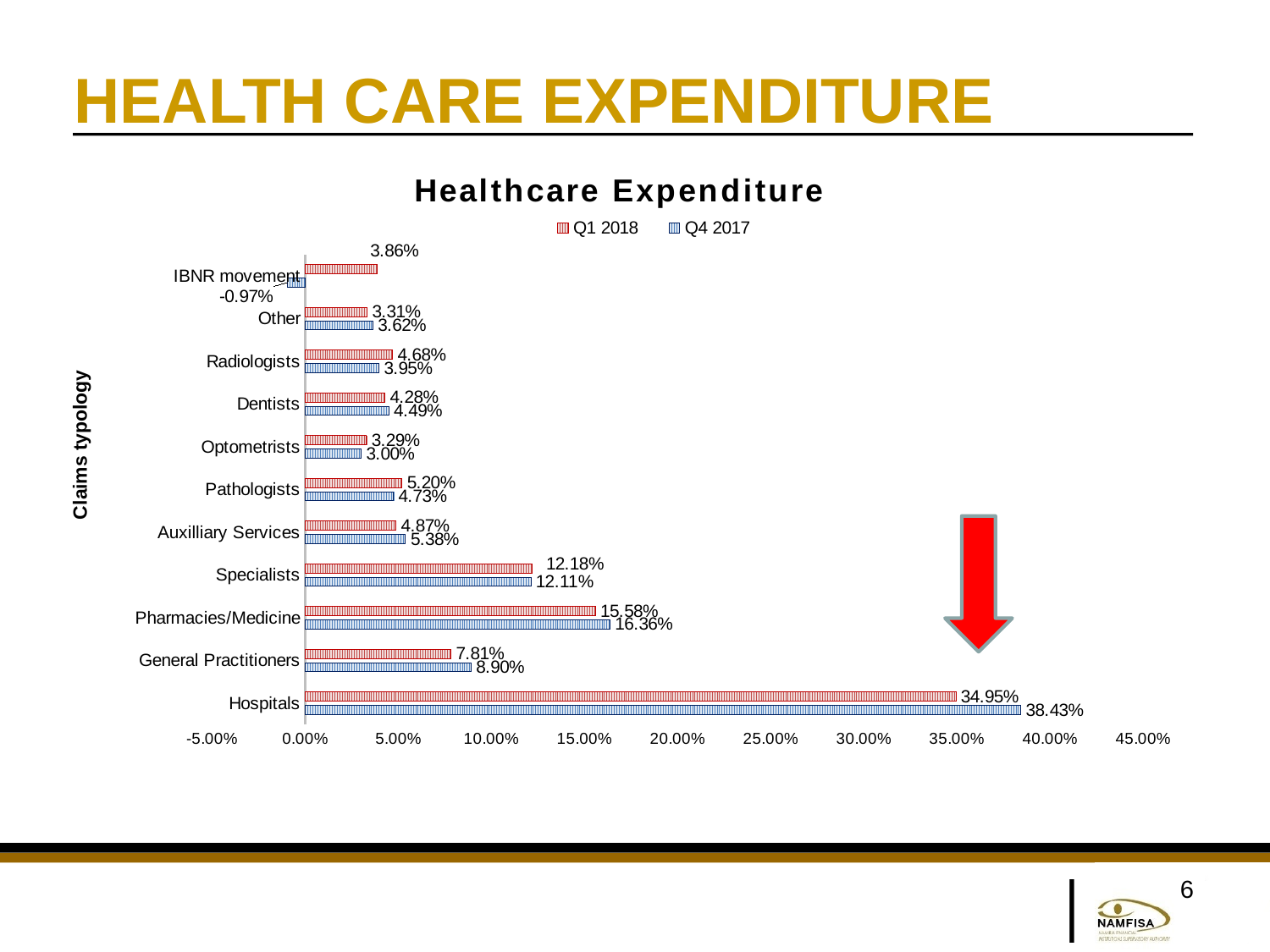
What is the difference between the Q4 2017 and Q1 2018 values for Hospitals? 3.48% What is the Q4 2017 value for Pharmacies/Medicine? 16.36% What type of chart is shown on the slide? Bar chart How many series does the legend list? 2 How many claims typology categories are shown on the chart? 11 What is the Q1 2018 value for General Practitioners? 7.81% What is the Q4 2017 value for IBNR movement? -0.97% What is the title of the chart? Healthcare Expenditure Which claims typology has the highest Q4 2017 value? Hospitals Which is larger for Radiologists: the Q1 2018 value or the Q4 2017 value? Q1 2018 Which claims typology has the lowest Q4 2017 value? IBNR movement What is the Q1 2018 value for Hospitals? 34.95%